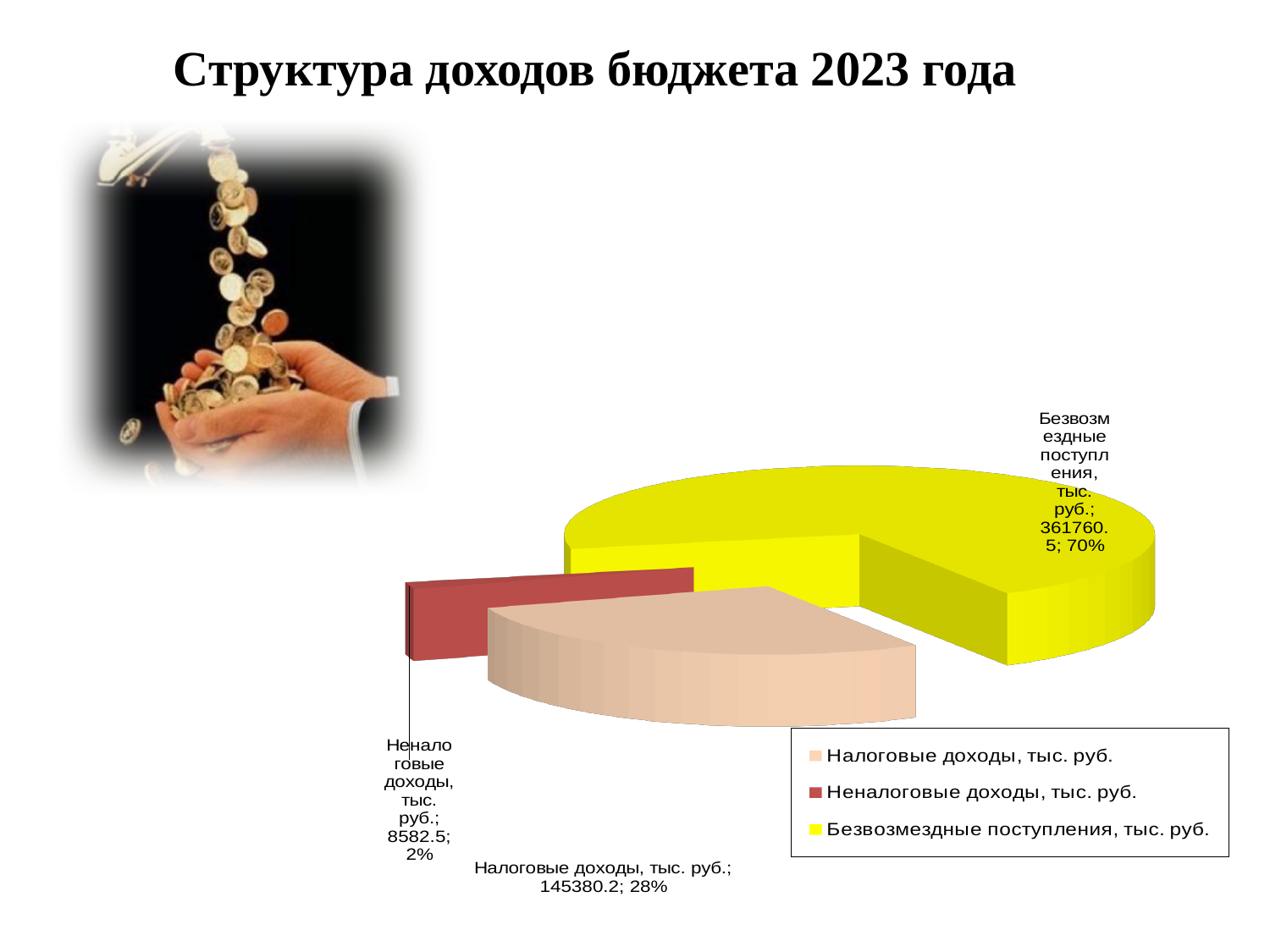
What kind of chart is shown on the slide? pie chart Which category has the smallest slice of the pie? Неналоговые доходы, тыс. руб. What is the value for Безвозмездные поступления, тыс. руб.? 361760.5 How many categories does the pie chart have? 3 What share of the pie does Налоговые доходы take? 28% Which is larger, Налоговые доходы or Неналоговые доходы? Налоговые доходы What is the value for Неналоговые доходы, тыс. руб.? 8582.5 What share of the pie does Неналоговые доходы take? 2% What is the difference between the values for Безвозмездные поступления and Налоговые доходы? 216380.3 What is the value for Налоговые доходы, тыс. руб.? 145380.2 What share of the pie does Безвозмездные поступления take? 70% Which category has the largest slice of the pie? Безвозмездные поступления, тыс. руб.